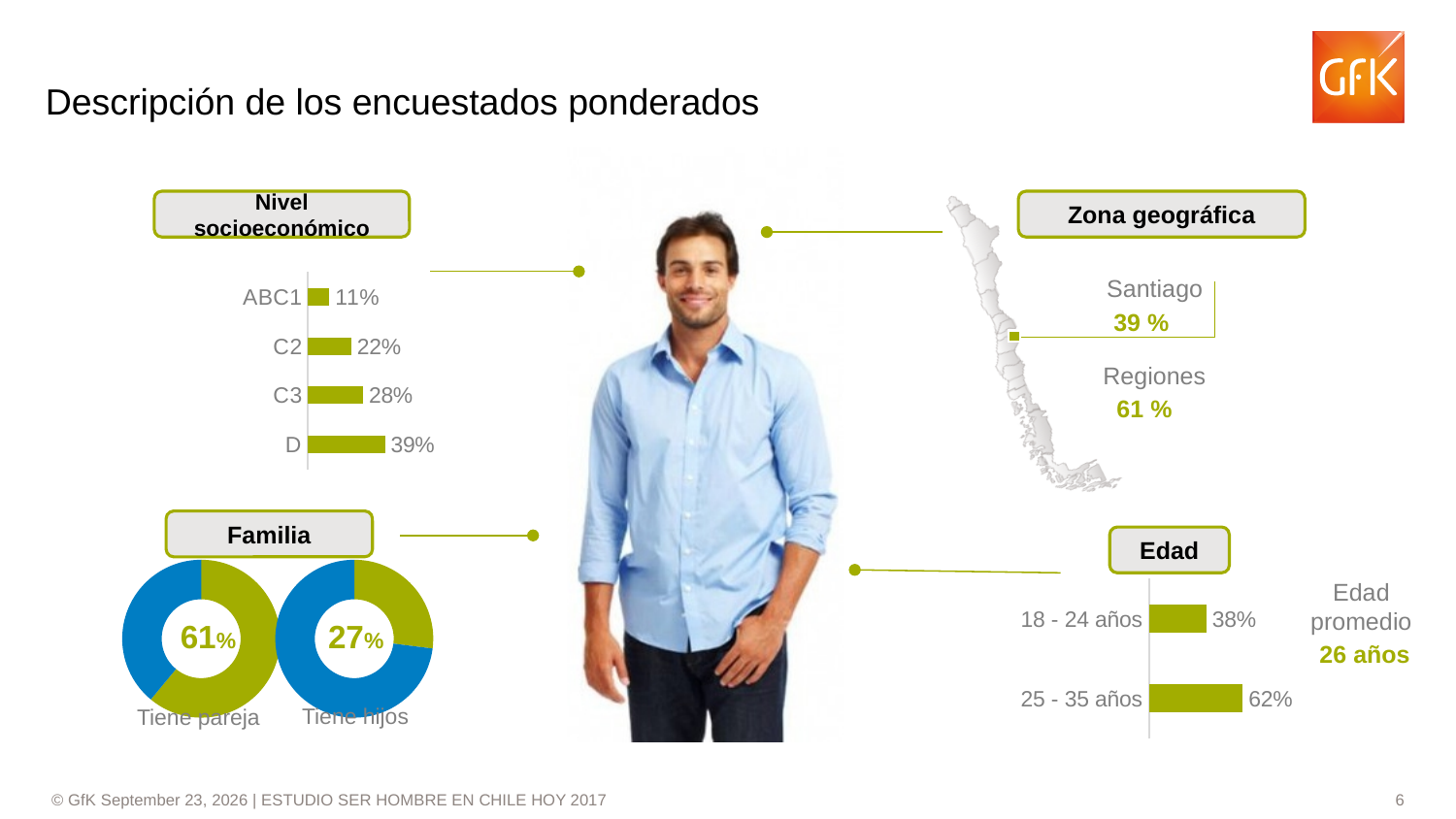
In the Familia donut charts, what share is shown for Tiene hijos? 27% In the Nivel socioeconómico chart, how many categories are shown? 4 In the Edad chart, what is the difference between the values for 25 - 35 años and 18 - 24 años? 24% In the Nivel socioeconómico chart, what is the value for C3? 28% What kind of chart is the Nivel socioeconómico chart? Bar chart In the Nivel socioeconómico chart, do the values rise or fall going from ABC1 down to D? Rise In the Edad chart, which is larger, 18 - 24 años or 25 - 35 años? 25 - 35 años In the Nivel socioeconómico chart, which category has the lowest value? ABC1 In the Nivel socioeconómico chart, which category has the highest value? D In the Edad chart, what is the value for 25 - 35 años? 62% In the Familia donut charts, what share is shown for Tiene pareja? 61% In the Nivel socioeconómico chart, what is the difference between the values for D and C2? 17%